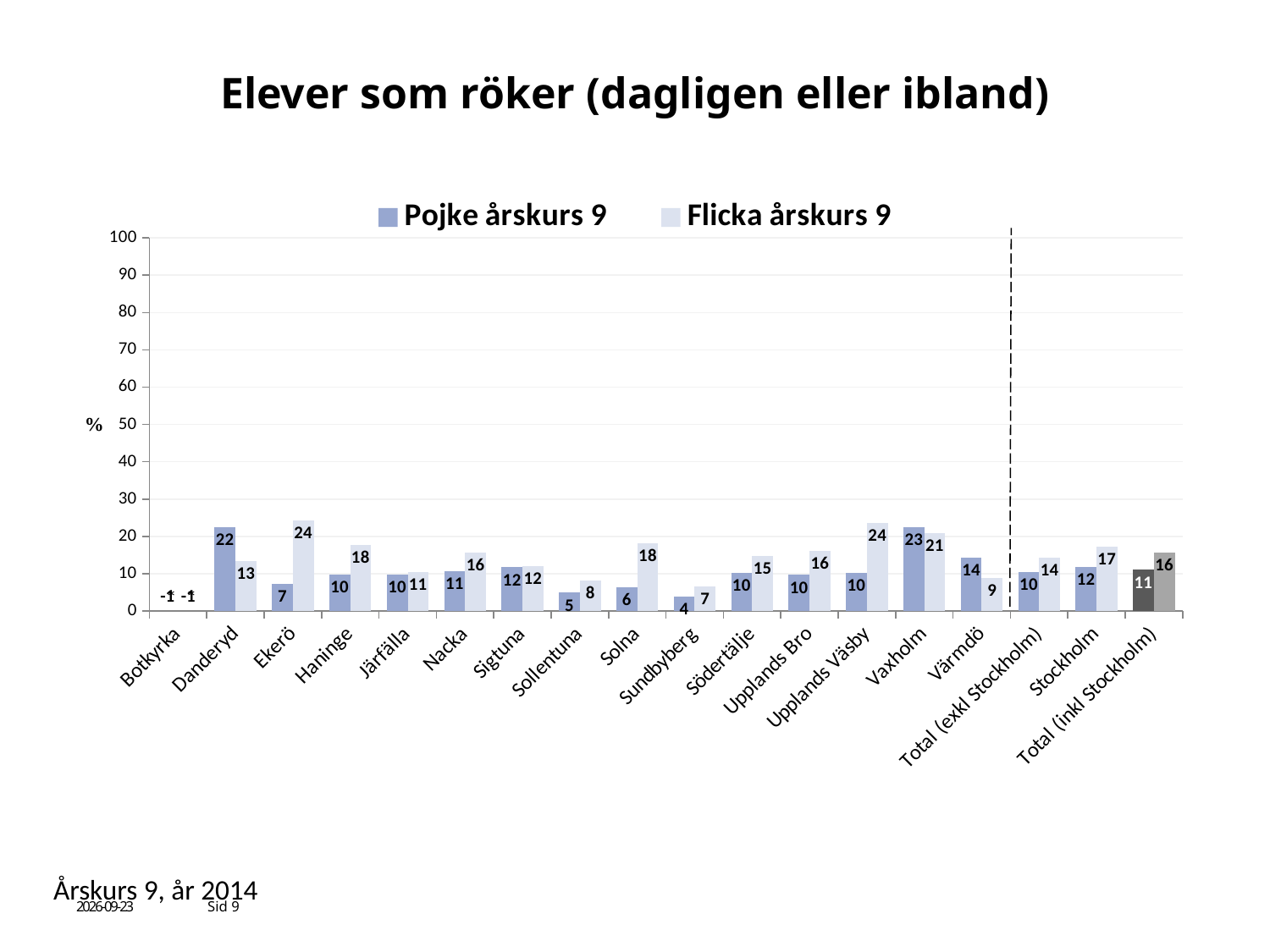
What is the value for Flicka årskurs 9 in Stockholm? 17 What is the value for Pojke årskurs 9 in Danderyd? 22 Which category has the highest value for Pojke årskurs 9? Vaxholm How many series does the legend list? 2 What is the title of the chart? Elever som röker (dagligen eller ibland) What is the difference between the Flicka årskurs 9 and Pojke årskurs 9 values in Upplands Väsby? 14 What kind of chart is shown on the slide? Bar chart How many categories are shown on the x axis? 18 What is the difference between the Flicka årskurs 9 and Pojke årskurs 9 values in Solna? 12 What is the value for Pojke årskurs 9 for Total (inkl Stockholm)? 11 What is the value for Flicka årskurs 9 in Ekerö? 24 In Värmdö, which series has the larger value, Pojke årskurs 9 or Flicka årskurs 9? Pojke årskurs 9